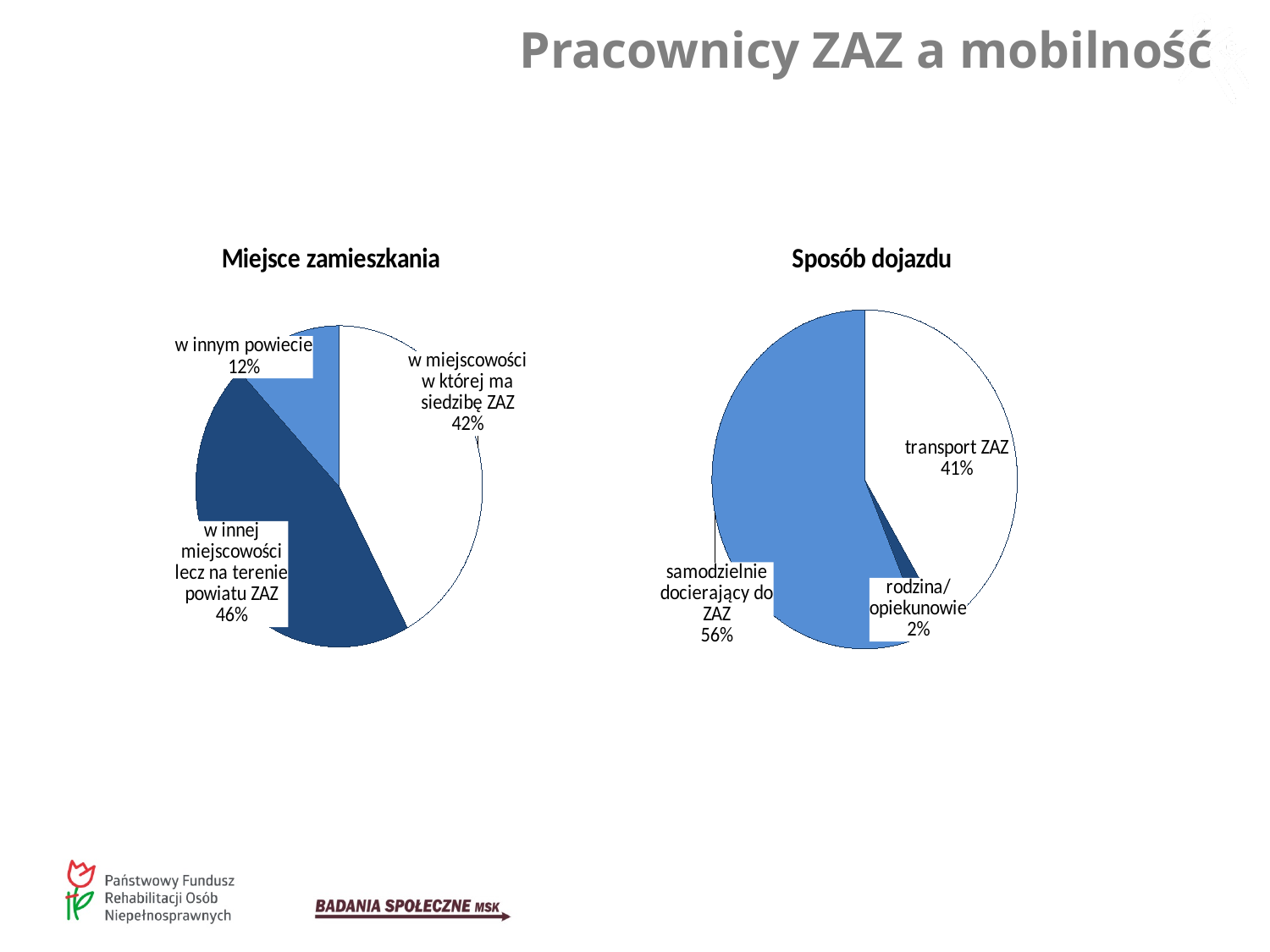
In the 'Sposób dojazdu' chart, which category has the largest share? samodzielnie docierający do ZAZ In the 'Miejsce zamieszkania' chart, which category has the largest share? w innej miejscowości lecz na terenie powiatu ZAZ In the 'Sposób dojazdu' chart, which is larger: 'transport ZAZ' or 'samodzielnie docierający do ZAZ'? samodzielnie docierający do ZAZ What type of chart is the 'Sposób dojazdu' chart? pie chart In the 'Miejsce zamieszkania' chart, what is the difference in percentage points between 'w innej miejscowości lecz na terenie powiatu ZAZ' and 'w innym powiecie'? 34 In the 'Miejsce zamieszkania' chart, what share is labelled for 'w innym powiecie'? 12% In the 'Sposób dojazdu' chart, what share is labelled for 'transport ZAZ'? 41% In the 'Sposób dojazdu' chart, what is the difference in percentage points between 'samodzielnie docierający do ZAZ' and 'transport ZAZ'? 15 In the 'Miejsce zamieszkania' chart, what share is labelled for 'w miejscowości w której ma siedzibę ZAZ'? 42% In the 'Sposób dojazdu' chart, what share is labelled for 'rodzina/ opiekunowie'? 2% How many slices does the 'Miejsce zamieszkania' chart have? 3 In the 'Miejsce zamieszkania' chart, which category has the smallest share? w innym powiecie